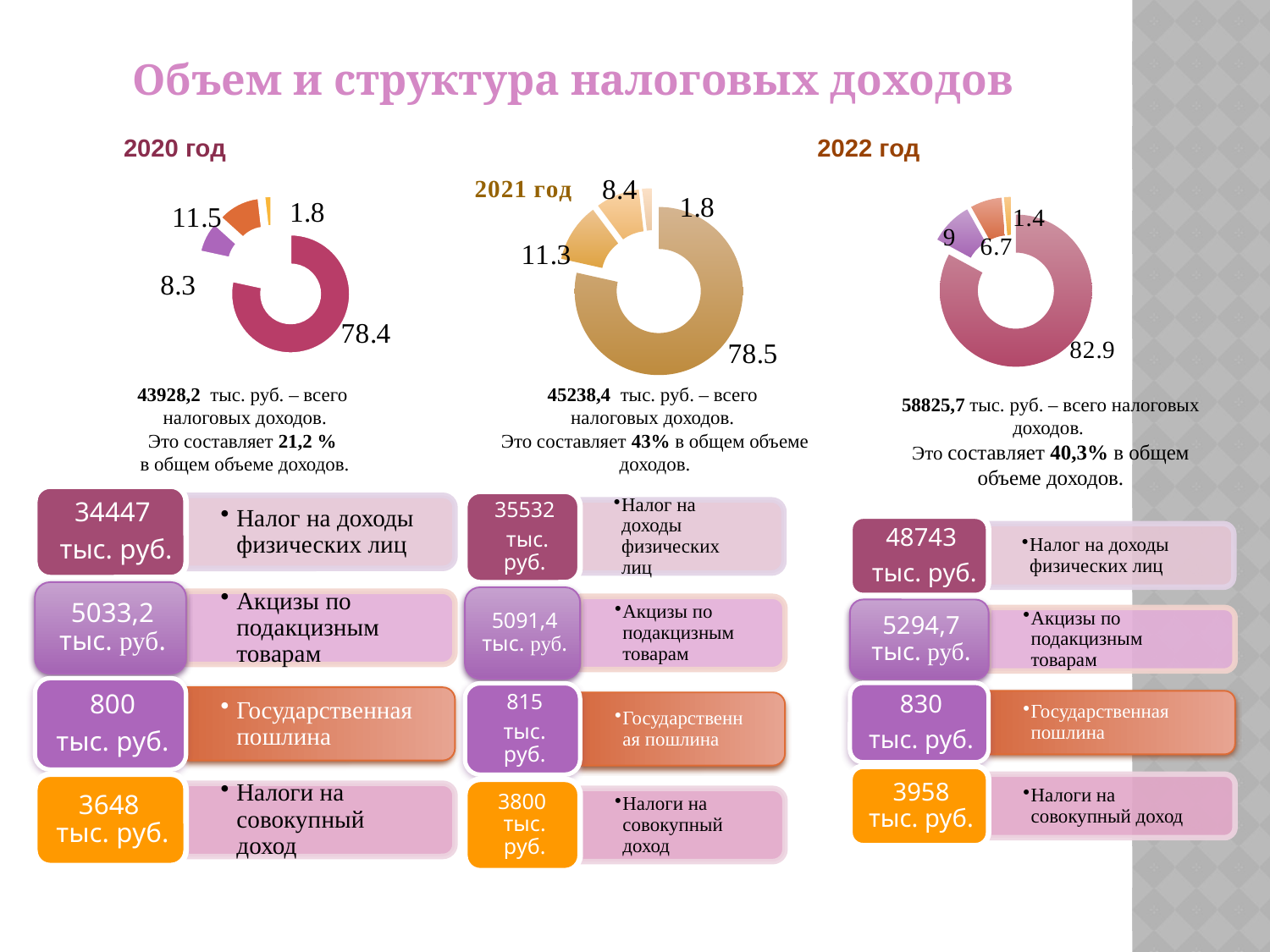
In the 2020 год chart, what is the difference between the slices labelled 11.5 and 8.3? 3.2 In the 2021 год chart, what is the value of the largest slice? 78.5 In the 2022 год chart, what is the value of the largest slice? 82.9 Which chart has the larger largest slice: the 2020 год chart (78.4) or the 2022 год chart (82.9)? 2022 год How many slices does the 2021 год chart have? 4 In the 2020 год chart, what is the value of the largest slice? 78.4 In the 2022 год chart, what is the difference between the largest slice (82.9) and the slice labelled 9? 73.9 In the 2020 год chart, what is the value of the smallest slice? 1.8 What kind of chart is used for the 2020 год chart? Donut chart How many slices does the 2020 год chart have? 4 In the 2022 год chart, what is the value of the smallest slice? 1.4 In the 2021 год chart, what is the value of the smallest slice? 1.8